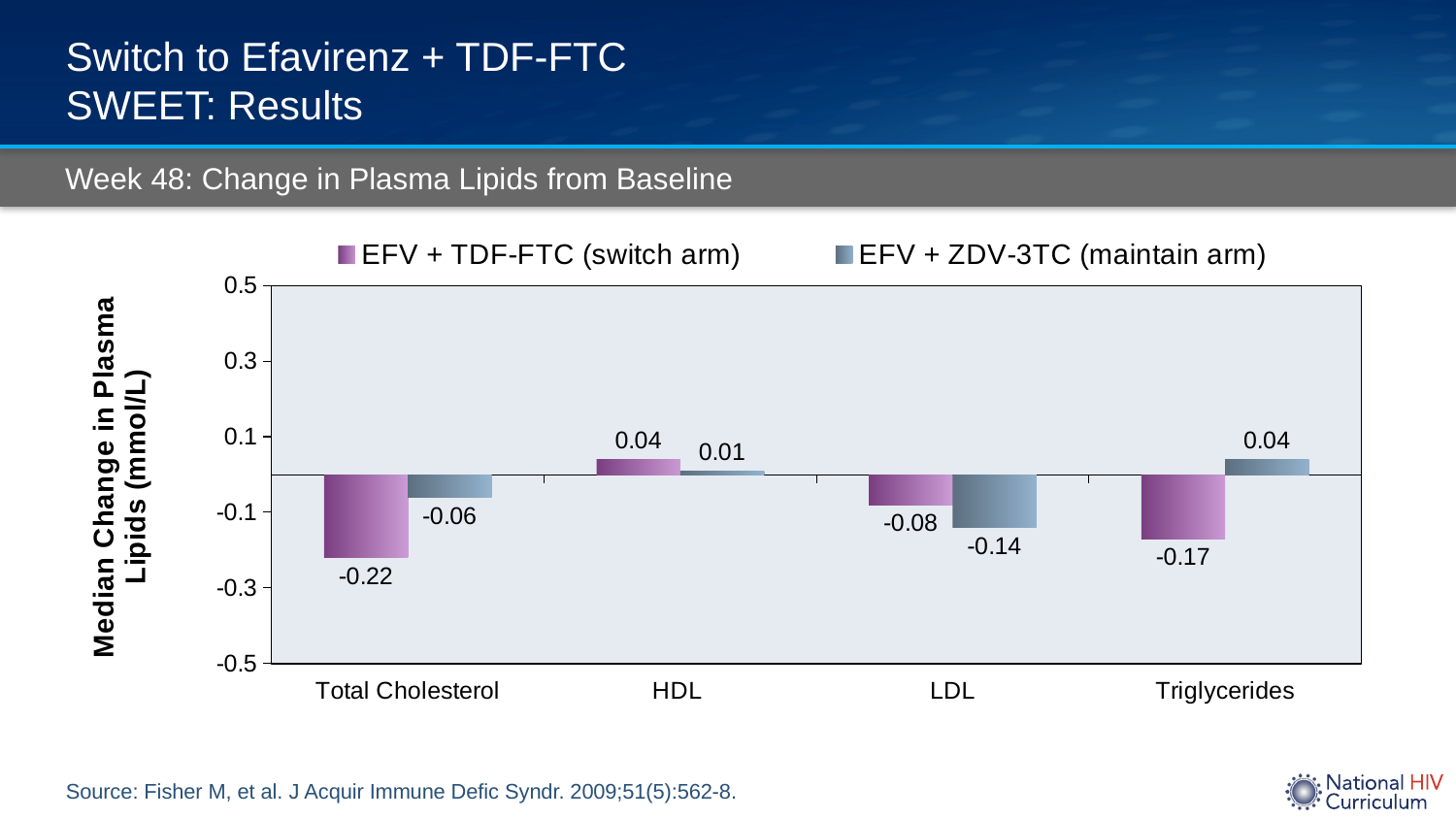
Which lipid category shows the lowest value for the EFV + TDF-FTC (switch arm)? Total Cholesterol What is the median change in HDL for the EFV + TDF-FTC (switch arm)? 0.04 Which lipid category shows the lowest value for the EFV + ZDV-3TC (maintain arm)? LDL What is the difference between the maintain arm and switch arm values for LDL? -0.06 What is the median change in total cholesterol for the EFV + TDF-FTC (switch arm)? -0.22 How many lipid categories are shown on the x axis? 4 What is the difference between the switch arm and maintain arm values for total cholesterol? 0.16 For triglycerides, which arm has the larger value, the switch arm or the maintain arm? EFV + ZDV-3TC (maintain arm) What is the median change in triglycerides for the EFV + ZDV-3TC (maintain arm)? 0.04 What is the median change in LDL for the EFV + ZDV-3TC (maintain arm)? -0.14 How many series does the legend list? 2 What kind of chart is shown on the slide? Bar chart